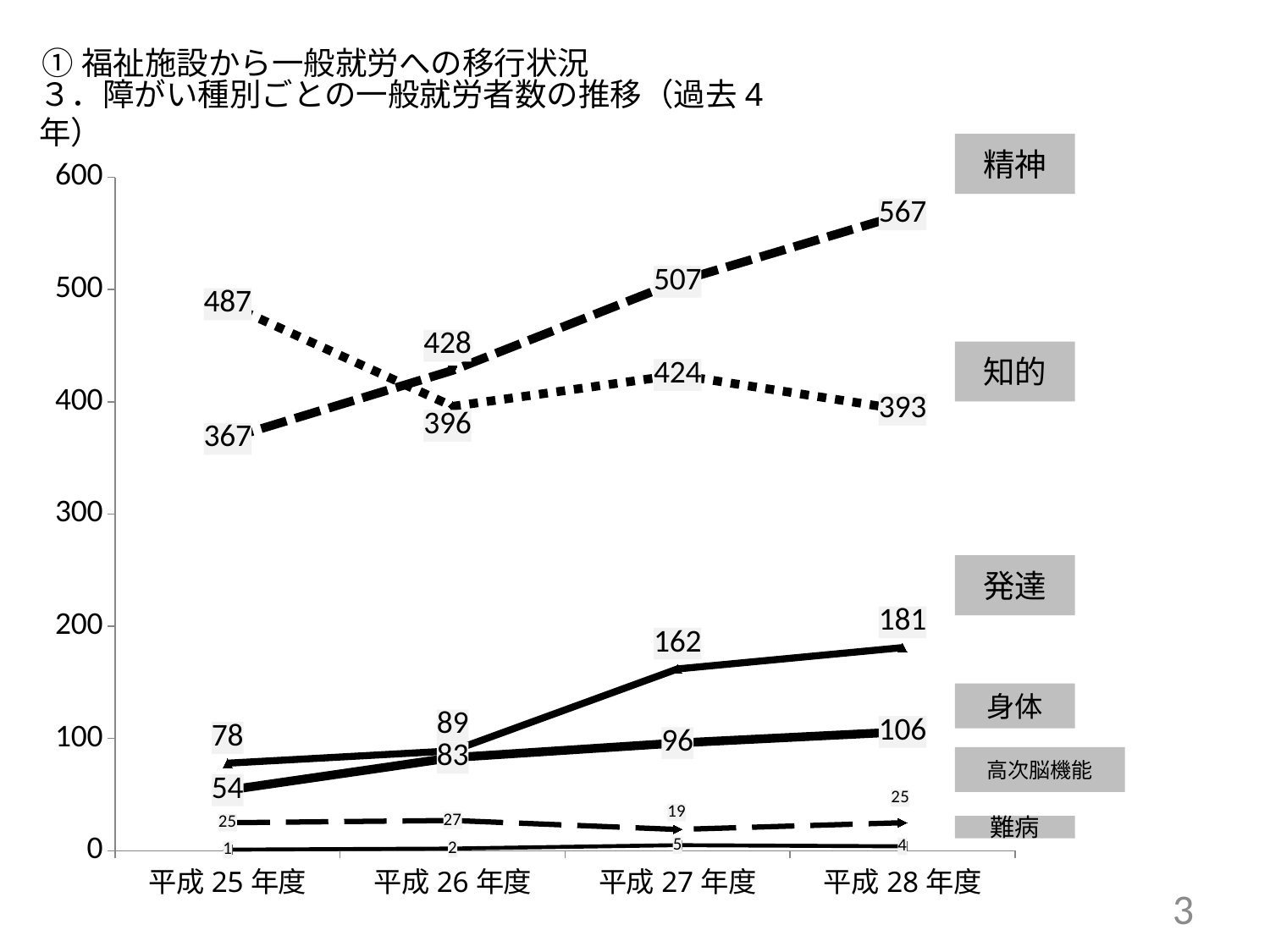
How many series are labelled on the right side of the chart? 6 What is the difference between the 精神 values in 平成28年度 and 平成25年度? 200 What is the value for 発達 in 平成27年度? 162 What kind of chart is shown on the slide? line chart What is the value for 身体 in 平成28年度? 106 What is the value for 精神 in 平成28年度? 567 Which is larger in 平成26年度, 精神 or 知的? 精神 How many years are shown on the x axis? 4 What is the value for 知的 in 平成25年度? 487 Does the value for 精神 rise or fall from 平成25年度 to 平成28年度? rise In which year is the value for 知的 lowest? 平成28年度 In which year is the value for 精神 highest? 平成28年度